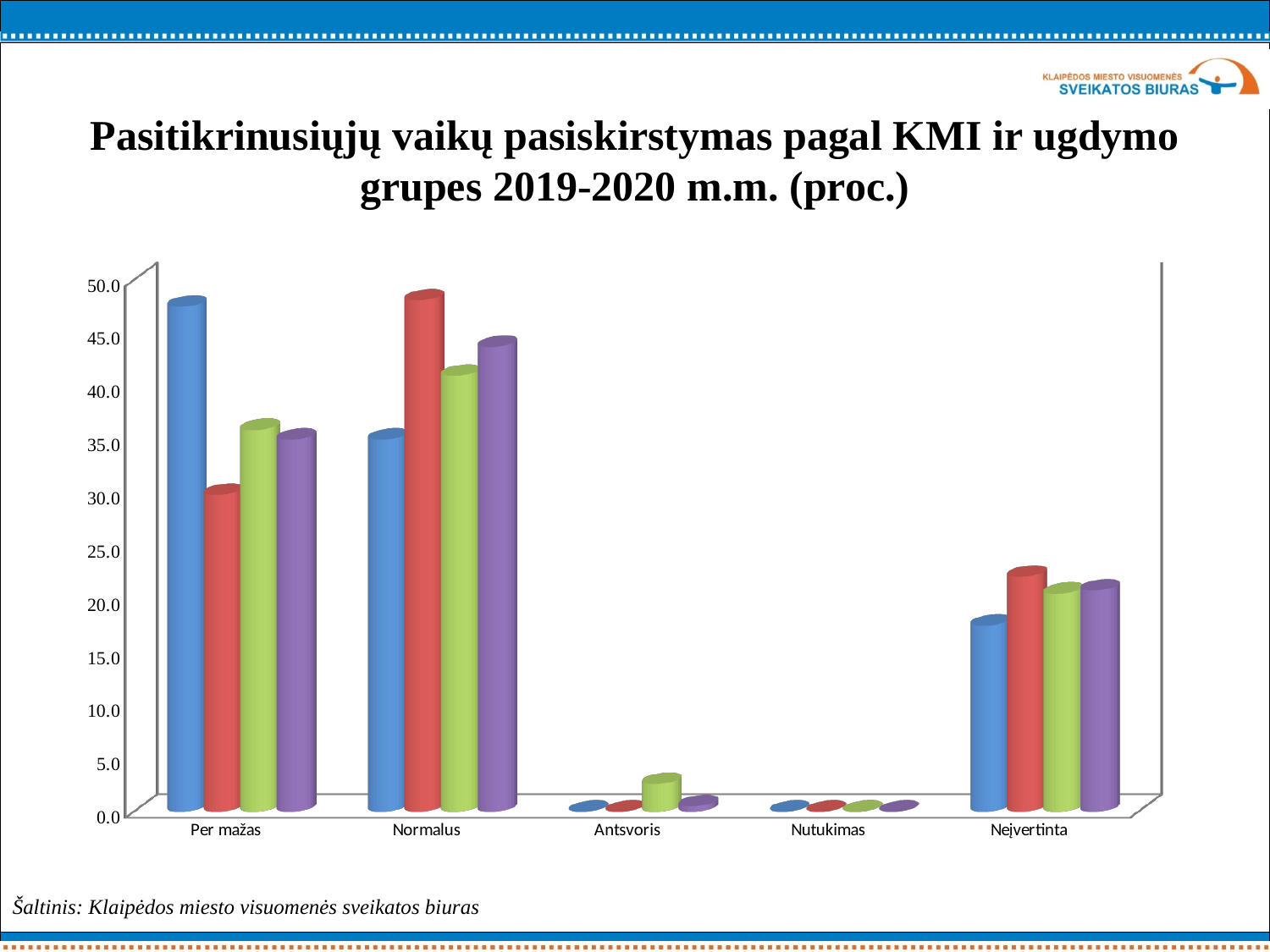
Are the values for Neįvertinta greater or less than 15.0? greater Are the values for Nutukimas greater or less than 5.0? less Are the values for Per mažas greater or less than 25.0? greater What is the title of the chart on the slide? Pasitikrinusiųjų vaikų pasiskirstymas pagal KMI ir ugdymo grupes 2019-2020 m.m. (proc.) What is the highest value shown on the vertical axis of the chart? 50.0 How many bars are plotted for each category in the chart? 4 Which category has the lowest values in the chart? Nutukimas What kind of chart is shown on the slide? bar chart How many categories are shown on the x axis of the chart? 5